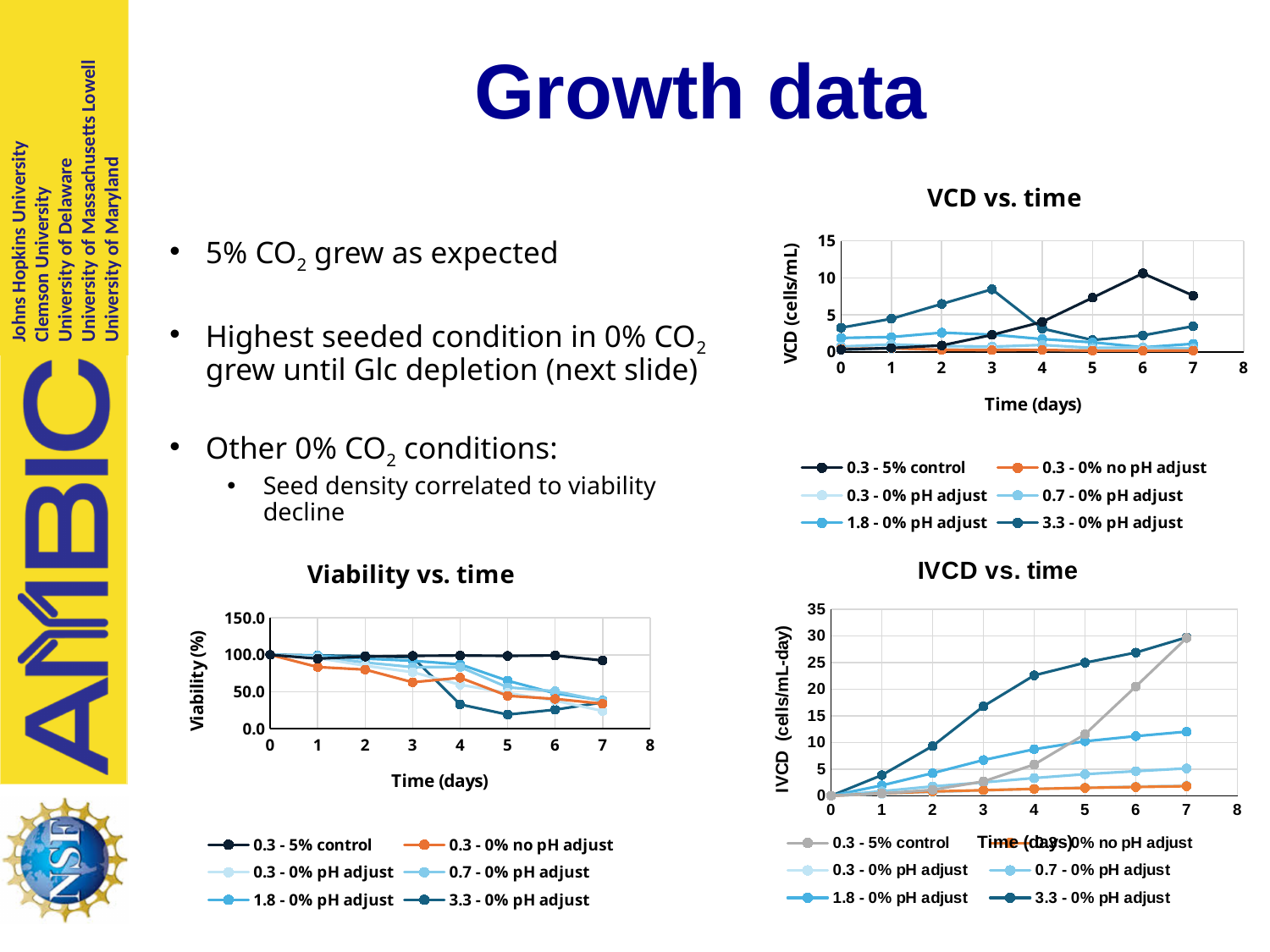
What is the y-axis label of the 'IVCD vs. time' chart? IVCD (cells/mL-day) In the 'Viability vs. time' chart, is the value for 3.3 - 0% pH adjust at day 5 greater or less than 50.0? less In the 'IVCD vs. time' chart, is the value for 0.3 - 5% control at day 7 greater or less than 25? greater In the 'IVCD vs. time' chart, which series has the highest value at day 4? 3.3 - 0% pH adjust How many series does the legend of the 'VCD vs. time' chart list? 6 In the 'VCD vs. time' chart, which series reaches the highest VCD value? 0.3 - 5% control In the 'VCD vs. time' chart, is the value for 3.3 - 0% pH adjust at day 3 greater or less than 5? greater In the 'IVCD vs. time' chart, how many time points are plotted for each series? 8 In the 'Viability vs. time' chart, which series has the lowest viability at day 5? 3.3 - 0% pH adjust What kind of chart is the 'VCD vs. time' chart? line chart In the 'Viability vs. time' chart, does the 0.3 - 0% no pH adjust series rise or fall from day 0 to day 7? fall